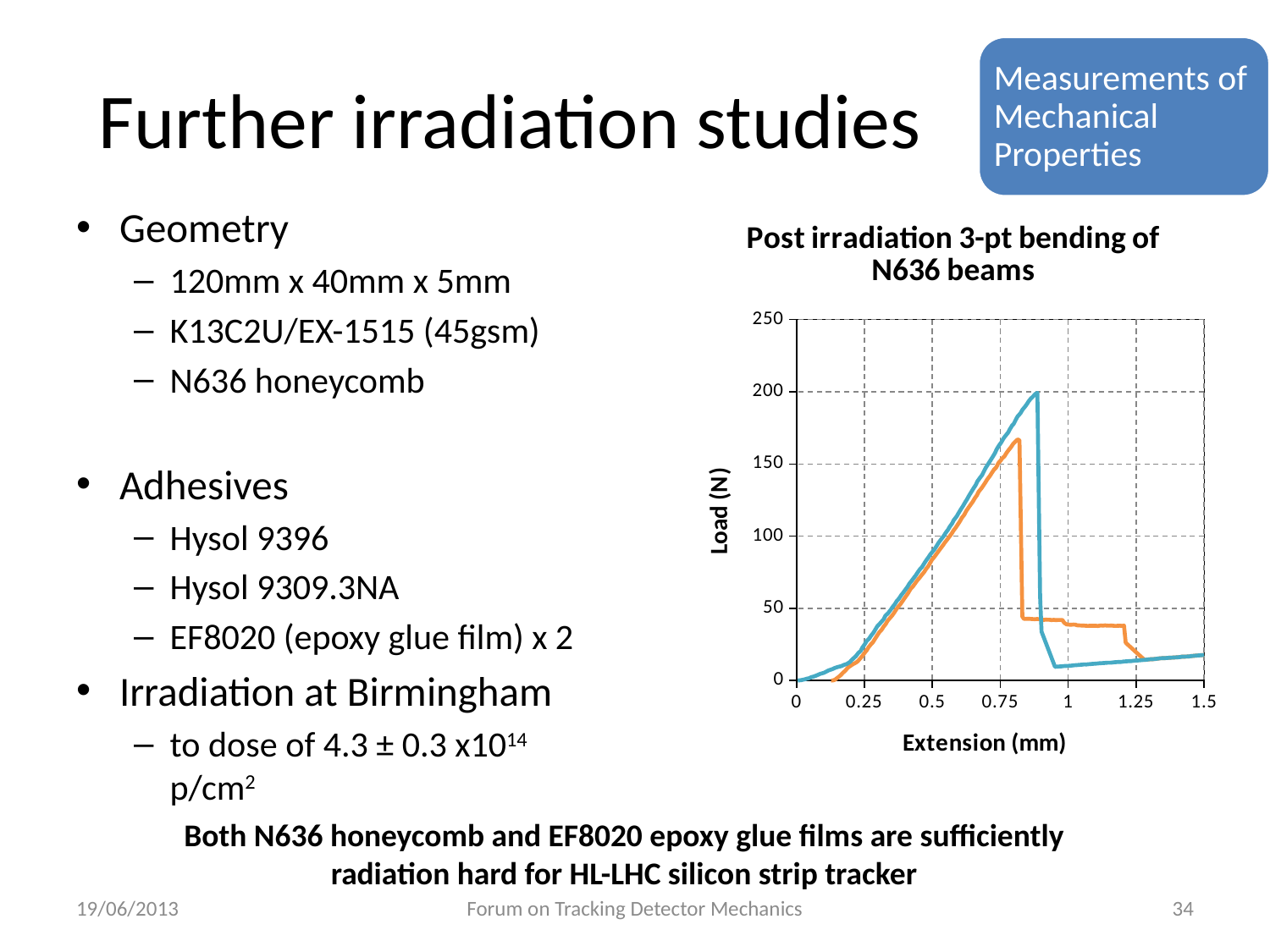
After its sharp drop, is the load of the blue line at an extension of 1 mm greater or less than 50? less Is the peak load of the orange line greater or less than 200? less What is the highest value shown on the Load (N) axis? 250 What kind of chart is shown on the slide? line chart Is the peak load of the blue line greater or less than 250? less What is the label of the vertical axis of the chart? Load (N) How many lines are plotted on the chart? 2 What is the title of the chart? Post irradiation 3-pt bending of N636 beams Which line reaches the higher peak load, the blue line or the orange line? blue line Does the load rise or fall as extension increases from 0 to 0.75 mm? rise